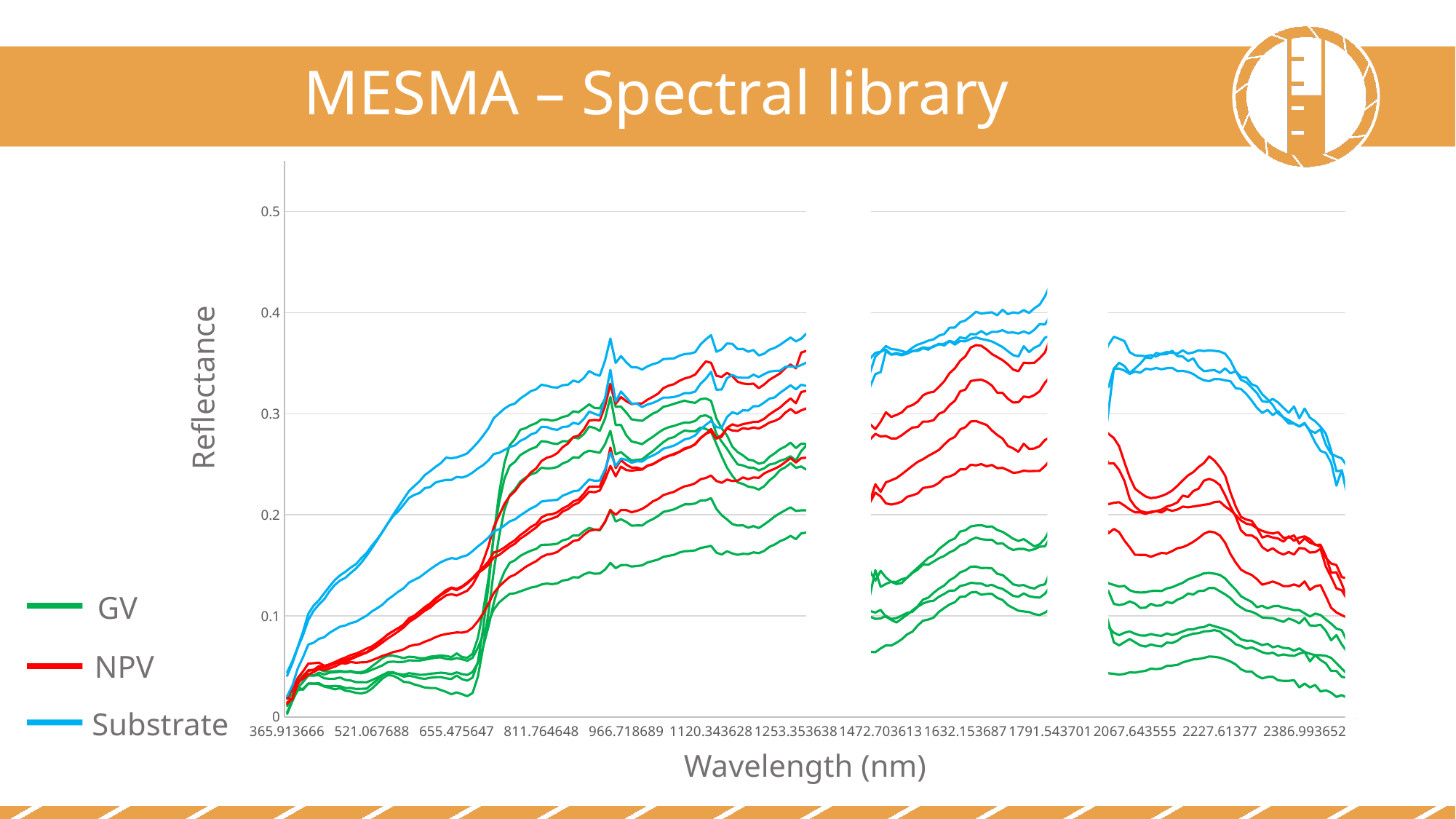
How many series does the legend list? 3 Which class has the highest reflectance at 1253.353638 nm? Substrate What is the label of the x axis? Wavelength (nm) Is the GV reflectance at 365.913666 nm greater or less than 0.1? less What kind of chart is shown on the slide? Line chart Is the NPV reflectance at 2067.643555 nm greater or less than 0.3? less Do the Substrate curves rise or fall between 2227.61377 nm and 2386.993652 nm? fall What is the title of the slide's chart? MESMA – Spectral library Which class has the lowest reflectance at 2386.993652 nm? GV At 521.067688 nm, which is larger: the Substrate reflectance or the GV reflectance? Substrate Is the Substrate reflectance at 1791.543701 nm greater or less than 0.3? greater How many wavelength tick labels are shown on the x axis? 13